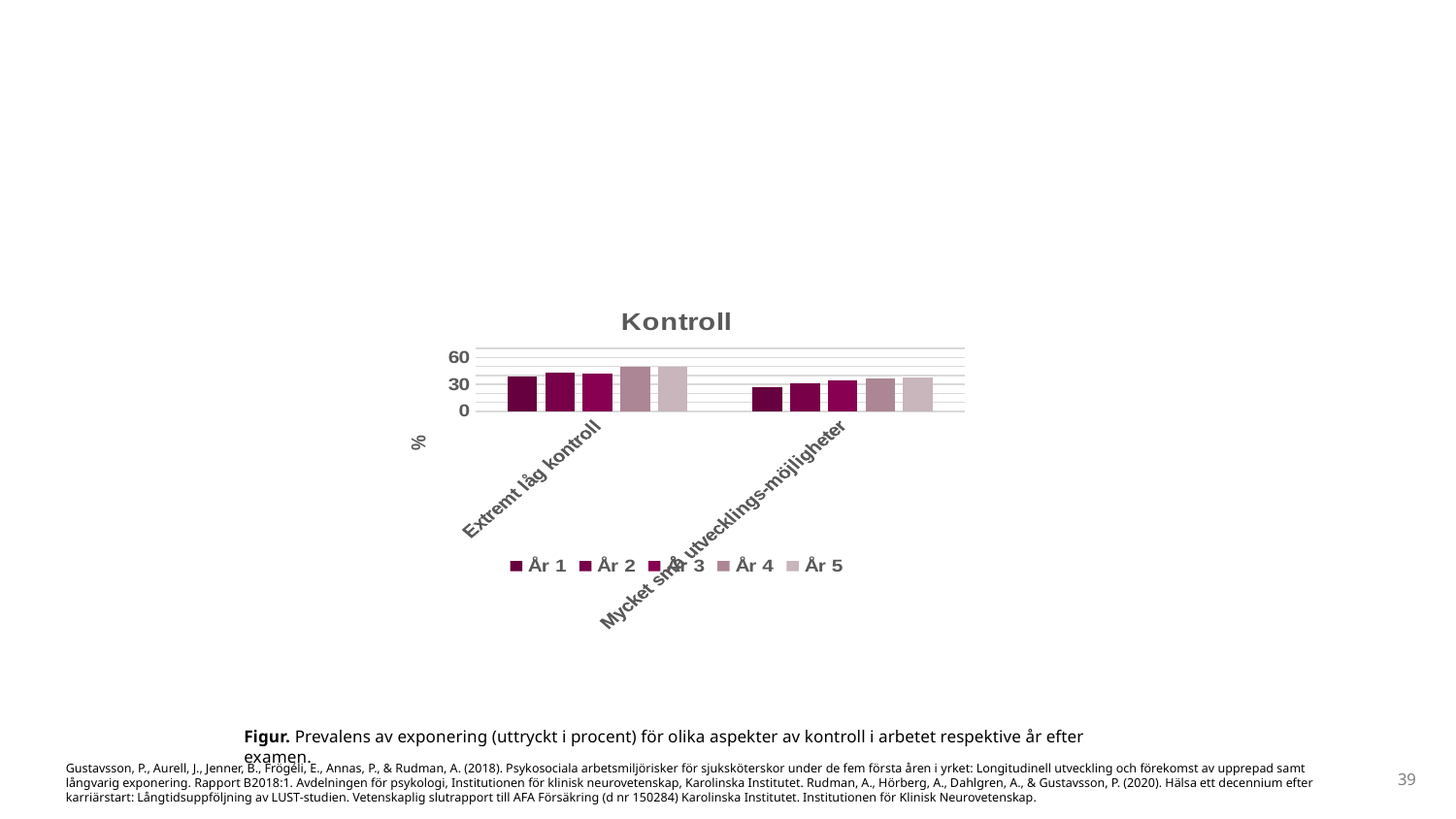
Is the value for År 5 in the category Mycket små utvecklings-möjligheter greater or less than 30? greater How many series does the legend list? 5 Is the value for År 5 in the category Extremt låg kontroll greater or less than 60? less What is the label on the vertical axis? % Within the category Mycket små utvecklings-möjligheter, which year has the lowest value? År 1 Which category has the larger value for År 1: Extremt låg kontroll or Mycket små utvecklings-möjligheter? Extremt låg kontroll What kind of chart is shown on the slide? bar chart Is the value for År 1 in the category Extremt låg kontroll greater or less than 30? greater Which category has the larger value for År 4: Extremt låg kontroll or Mycket små utvecklings-möjligheter? Extremt låg kontroll What is the title of the chart? Kontroll How many categories are shown on the x axis? 2